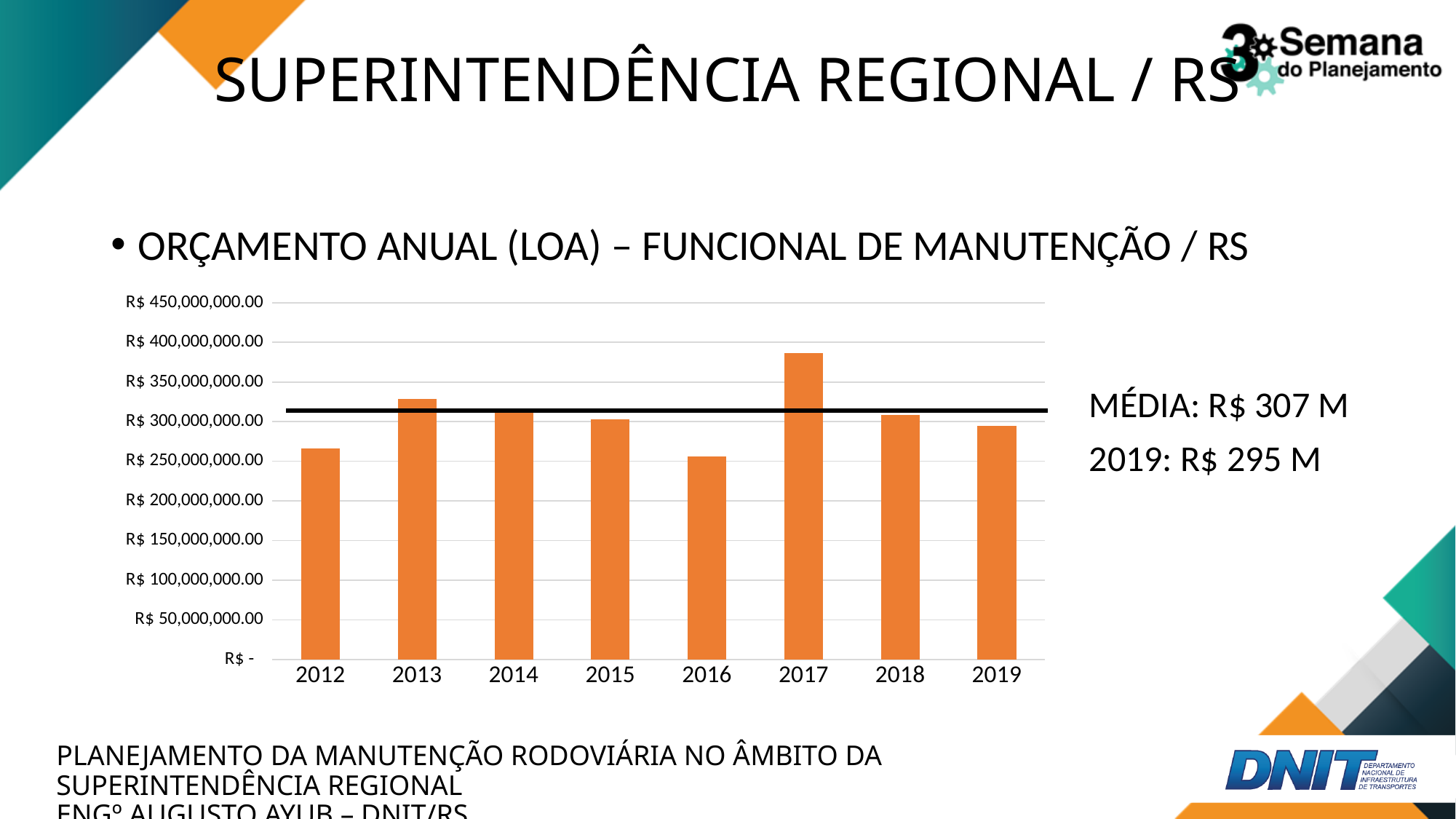
According to the text next to the chart, what is the value for 2019? R$ 295 M Which year has the highest bar in the chart? 2017 Is the value for 2013 greater or less than R$ 300,000,000.00? greater Did the value rise or fall from 2017 to 2018? fall How many years are plotted on the x axis of the chart? 8 Which year has the larger value, 2013 or 2017? 2017 Is the value for 2016 greater or less than R$ 300,000,000.00? less Is the value for 2017 greater or less than R$ 350,000,000.00? greater According to the text next to the chart, what is the average (MÉDIA) value? R$ 307 M What kind of chart is shown on the slide? bar chart Which year has the lowest bar in the chart? 2016